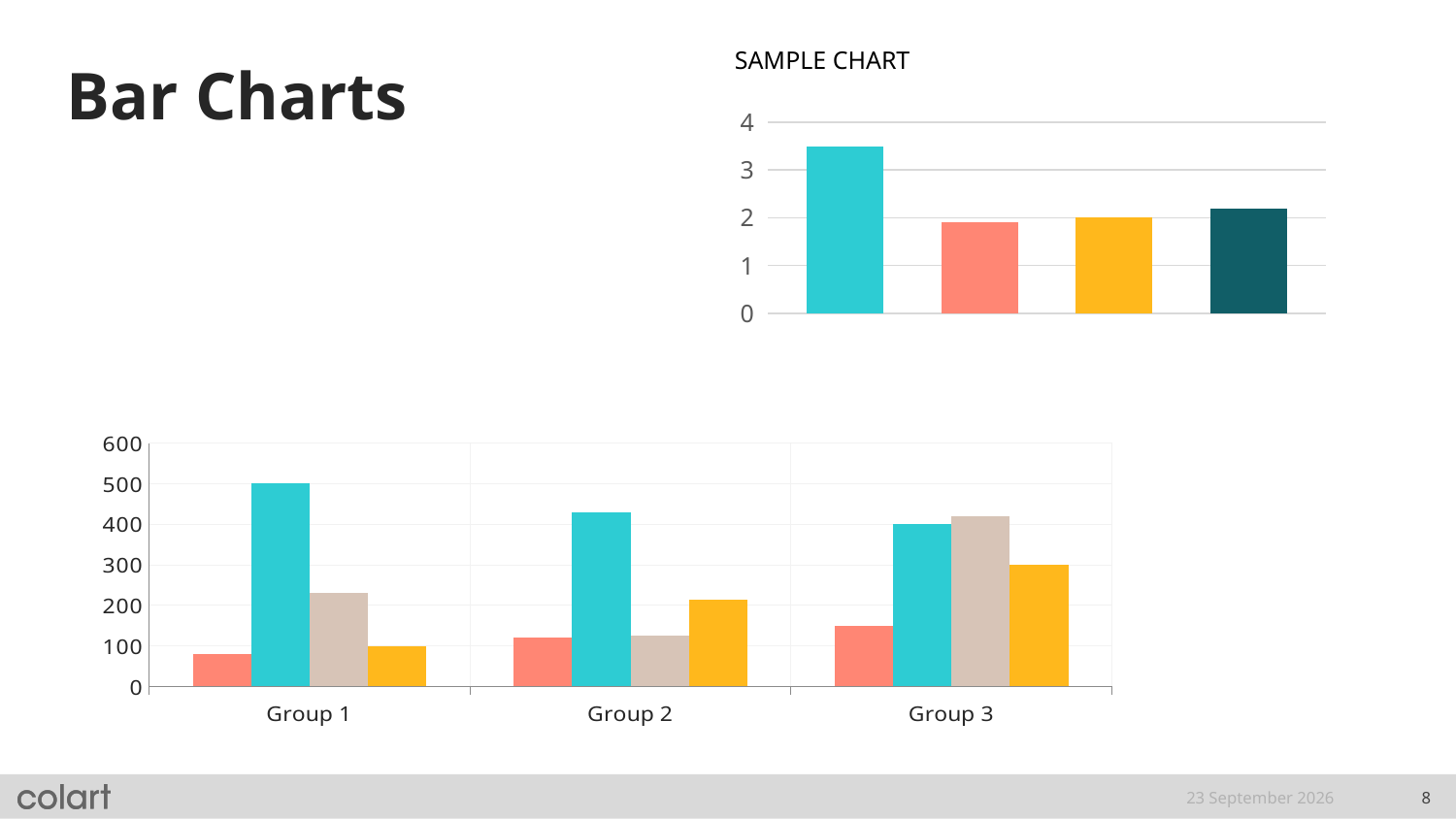
In the bottom chart, is the value of the salmon (first) bar in Group 1 greater or less than 100? less What type of chart is the bottom chart with Group 1, Group 2 and Group 3? bar chart In the SAMPLE CHART at the top right, which bar is the highest? the first (teal) bar How many bars are plotted in the SAMPLE CHART at the top right? 4 In the bottom chart, which is larger: the teal bar in Group 2 or the teal bar in Group 3? the teal bar in Group 2 What type of chart is the SAMPLE CHART at the top right of the slide? bar chart In the SAMPLE CHART at the top right, is the value of the first (teal) bar greater or less than 3? greater In the SAMPLE CHART at the top right, is the value of the fourth (dark teal) bar greater or less than 2? greater How many groups (categories) are shown on the x axis of the bottom chart? 3 In the bottom chart, which bar is the highest in Group 1? the teal bar In the bottom chart, how many bars are plotted for each group? 4